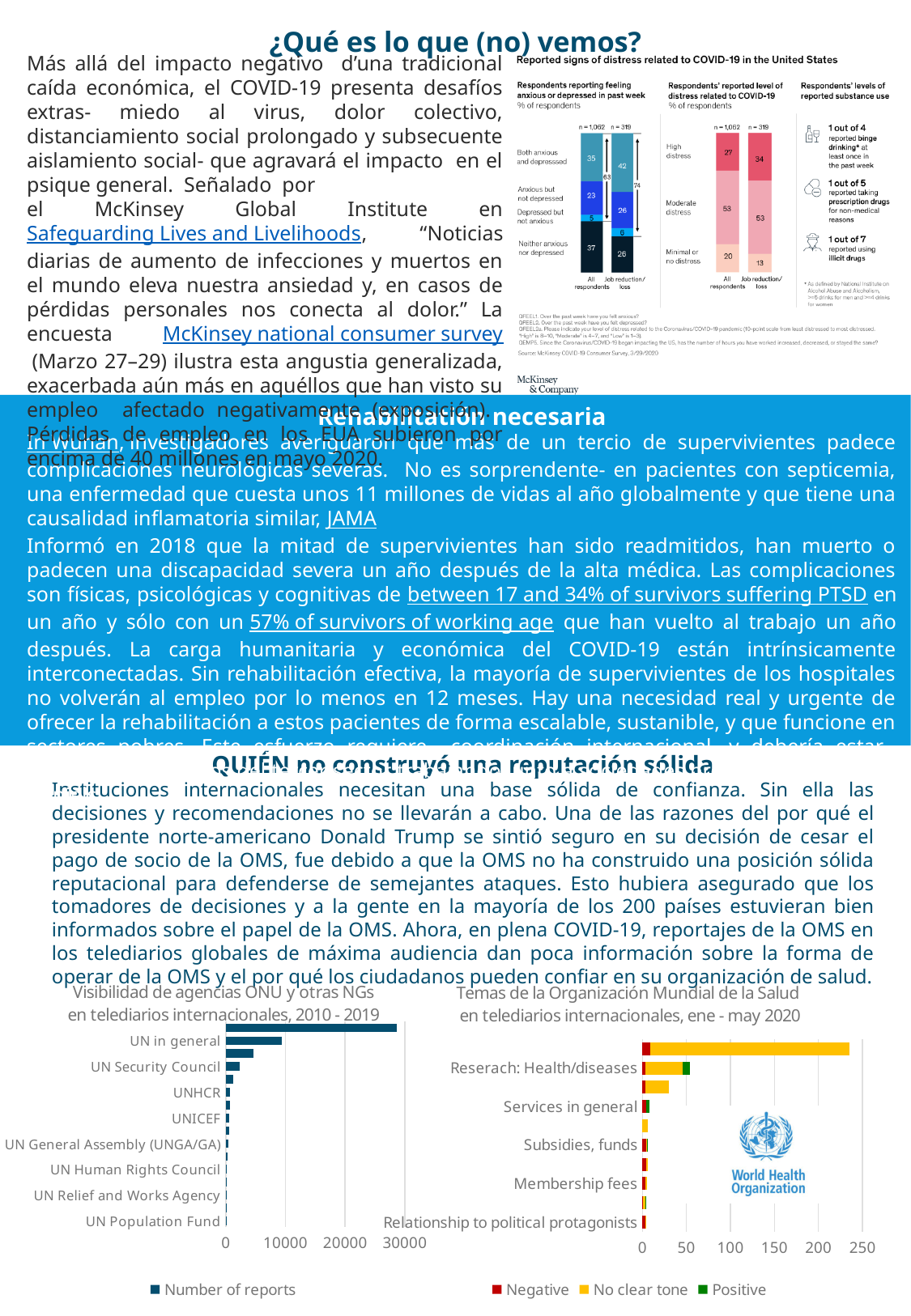
In the McKinsey chart 'Respondents' reported level of distress related to COVID-19', what is the difference in high distress between the job reduction/loss group (34) and all respondents (27)? 7 In the bottom-left chart on UN agency visibility, what is the legend entry? Number of reports In the McKinsey chart 'Respondents reporting feeling anxious or depressed in past week', what percentage of all respondents were neither anxious nor depressed? 37 In the bottom-right chart titled 'Temas de la Organización Mundial de la Salud en telediarios internacionales, ene - may 2020', how many series does the legend list? 3 What kind of chart is the bottom-right chart on World Health Organization topics? Bar chart In the bottom-left chart on UN agency visibility, is the value for 'UN in general' greater or less than 20000? less In the bottom-left chart on UN agency visibility, how many series does the legend list? 1 In the bottom-right chart on World Health Organization topics, what are the three legend entries? Negative, No clear tone, Positive In the McKinsey chart 'Respondents' reported level of distress related to COVID-19', what percentage of respondents with job reduction/loss reported moderate distress? 53 What kind of chart is the bottom-left chart titled 'Visibilidad de agencias ONU y otras NGs en telediarios internacionales, 2010 - 2019'? Bar chart In the McKinsey chart 'Respondents' reported level of distress related to COVID-19', what percentage of all respondents reported high distress? 27